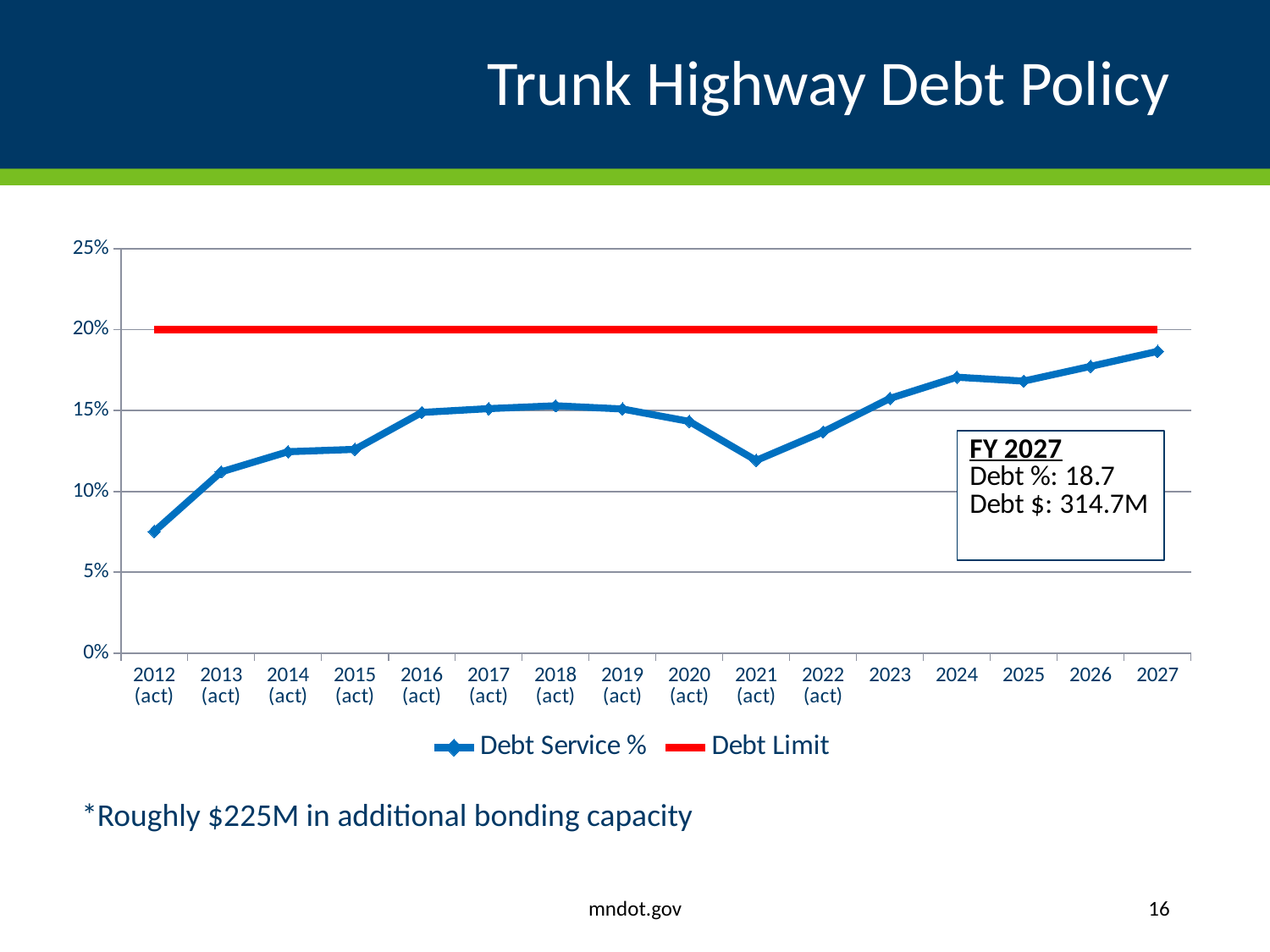
Is the Debt Service % for 2012 (act) greater or less than 10%? less How many years are shown along the x axis? 16 According to the FY 2027 annotation, what is the Debt % for 2027? 18.7 Does the Debt Service % rise or fall from 2021 to 2027? rise How many series does the legend list? 2 Which year has the lowest Debt Service %? 2012 (act) Is the Debt Service % for 2024 greater or less than 15%? greater Which is larger, the Debt Service % for 2018 (act) or for 2021 (act)? 2018 (act) What type of chart is shown on the slide? line chart Is the Debt Service % for 2021 (act) greater or less than 15%? less Which year has the highest Debt Service %? 2027 What is the value of the Debt Limit line? 20%